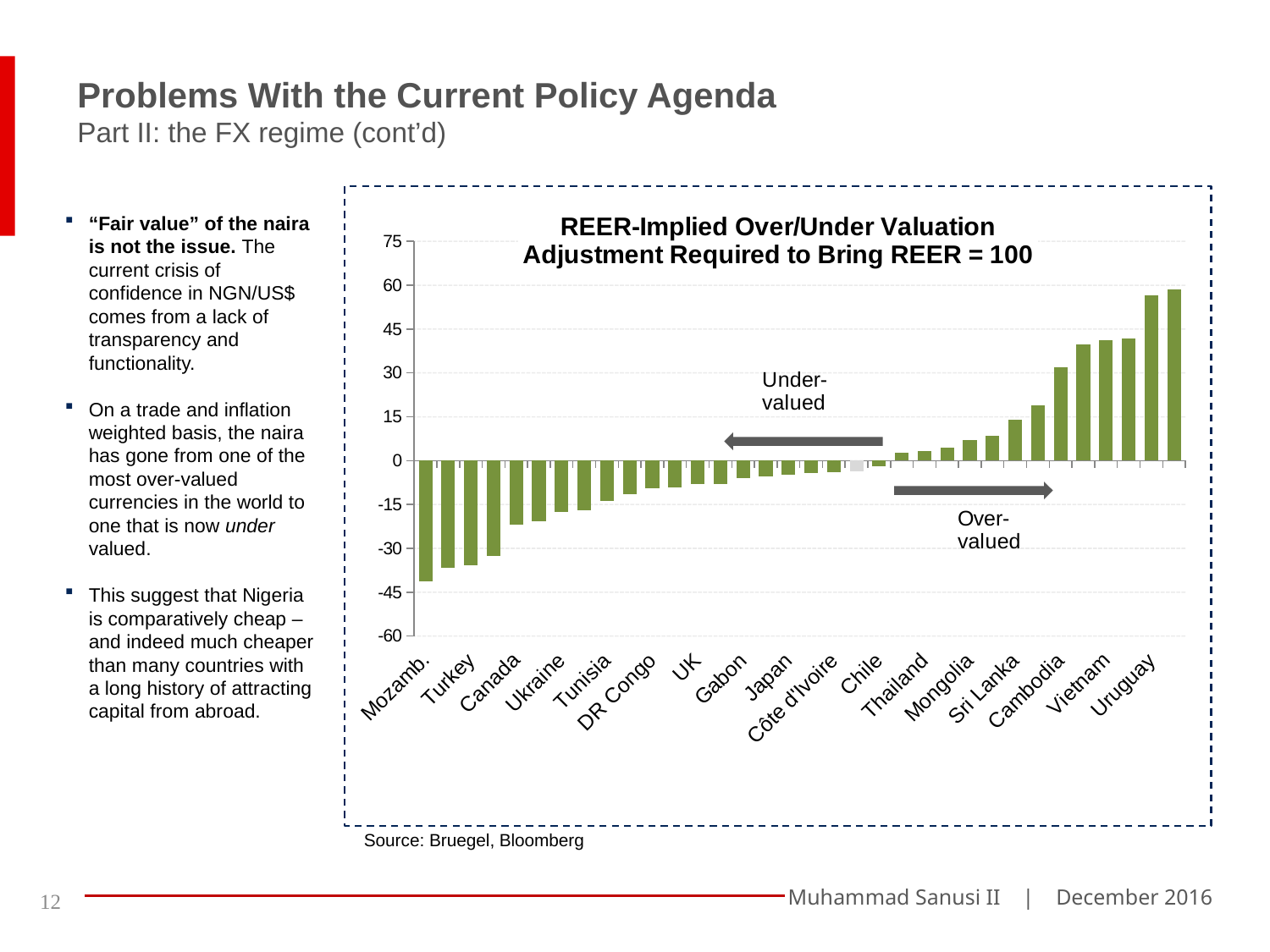
Which country has the lowest REER-implied valuation adjustment in the chart? Mozamb. Which has the larger value, Uruguay or Mozamb.? Uruguay Do the bar values rise or fall moving from left to right along the x axis? rise Is the value for Sri Lanka greater or less than 30? less Is the value for Turkey greater or less than -15? less Is the value for Vietnam greater or less than 30? greater What kind of chart is shown on the slide? bar chart What source is cited below the chart? Bruegel, Bloomberg What is the title of the chart? REER-Implied Over/Under Valuation Adjustment Required to Bring REER = 100